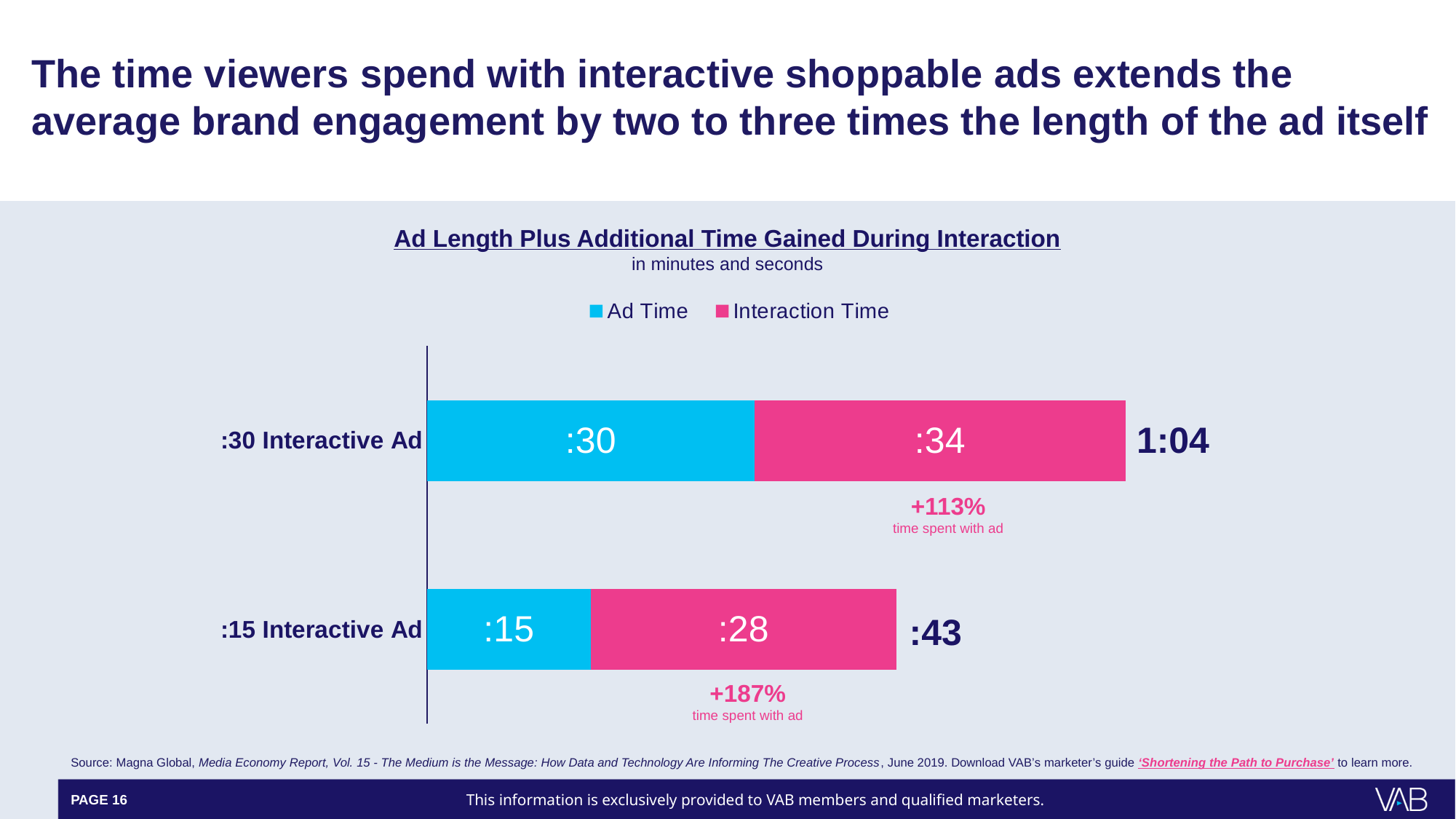
What is the Interaction Time value for the :30 Interactive Ad? :34 What is the title of the chart? Ad Length Plus Additional Time Gained During Interaction Which category has the highest total time? :30 Interactive Ad What is the total time shown for the :30 Interactive Ad bar? 1:04 What kind of chart is shown on the slide? Stacked bar chart What is the Interaction Time value for the :15 Interactive Ad? :28 Which category has the longer Interaction Time, the :30 Interactive Ad or the :15 Interactive Ad? :30 Interactive Ad What is the Ad Time value for the :30 Interactive Ad? :30 What is the total time shown for the :15 Interactive Ad bar? :43 How many series does the legend list? 2 How many categories are shown in the chart? 2 What percentage increase in time spent with ad is annotated for the :15 Interactive Ad? +187%